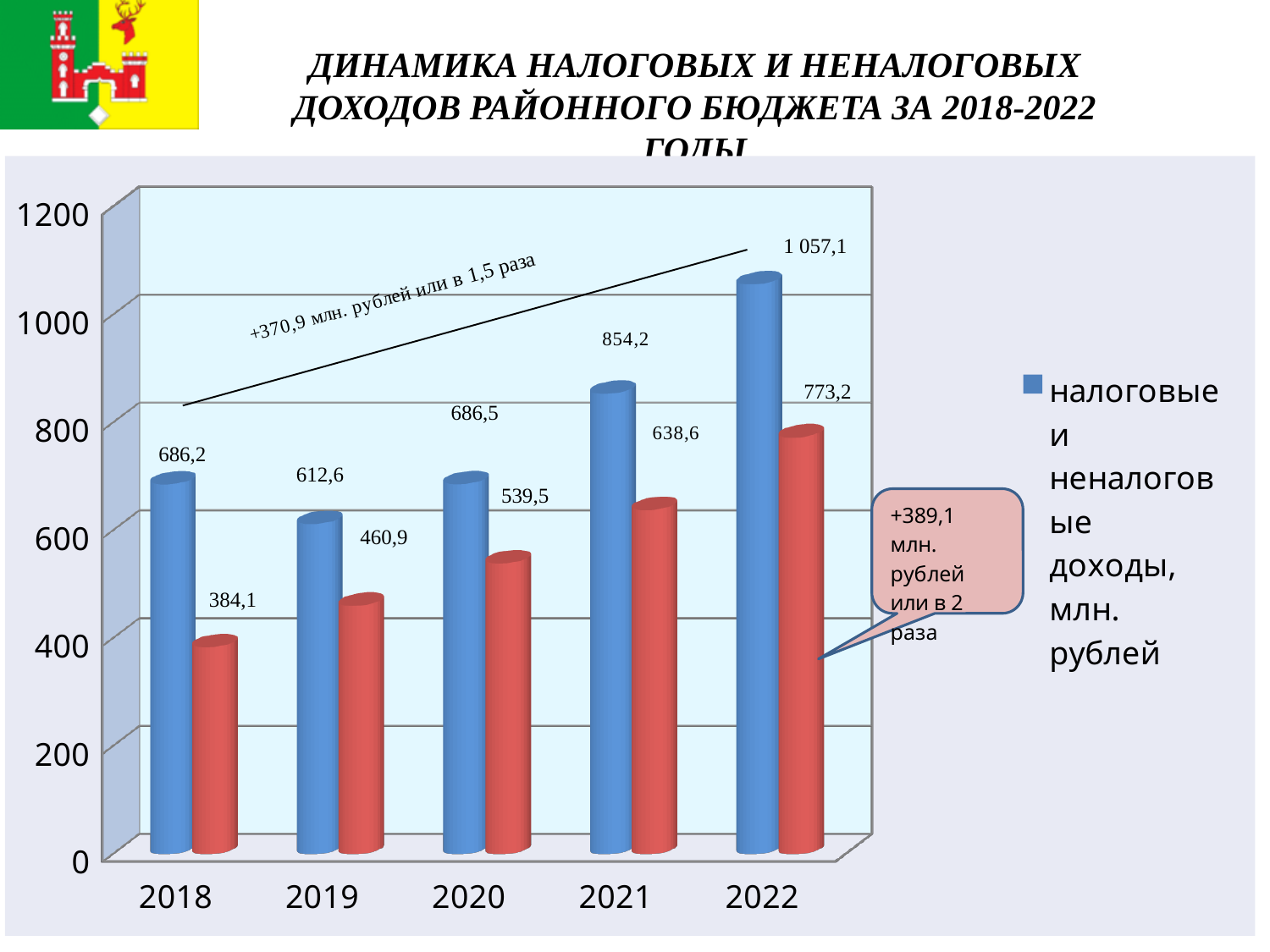
How many years are shown on the x axis? 5 Which is larger in 2020: the blue bar or the red bar? the blue bar What is the value of the red bar for 2021? 638,6 Do the red bar values rise or fall from 2018 to 2022? rise In which year is the red bar the lowest? 2018 In which year is the blue bar (налоговые и неналоговые доходы) the highest? 2022 What is the value of the red bar for 2018? 384,1 What does the annotation above the blue bars say about the growth from 2018 to 2022? +370,9 млн. рублей или в 1,5 раза What is the difference between the blue bar values for 2022 and 2018? 370,9 What type of chart is shown on the slide? bar chart What is the value of the blue bar (налоговые и неналоговые доходы) for 2022? 1 057,1 What is the value of the blue bar for 2019? 612,6